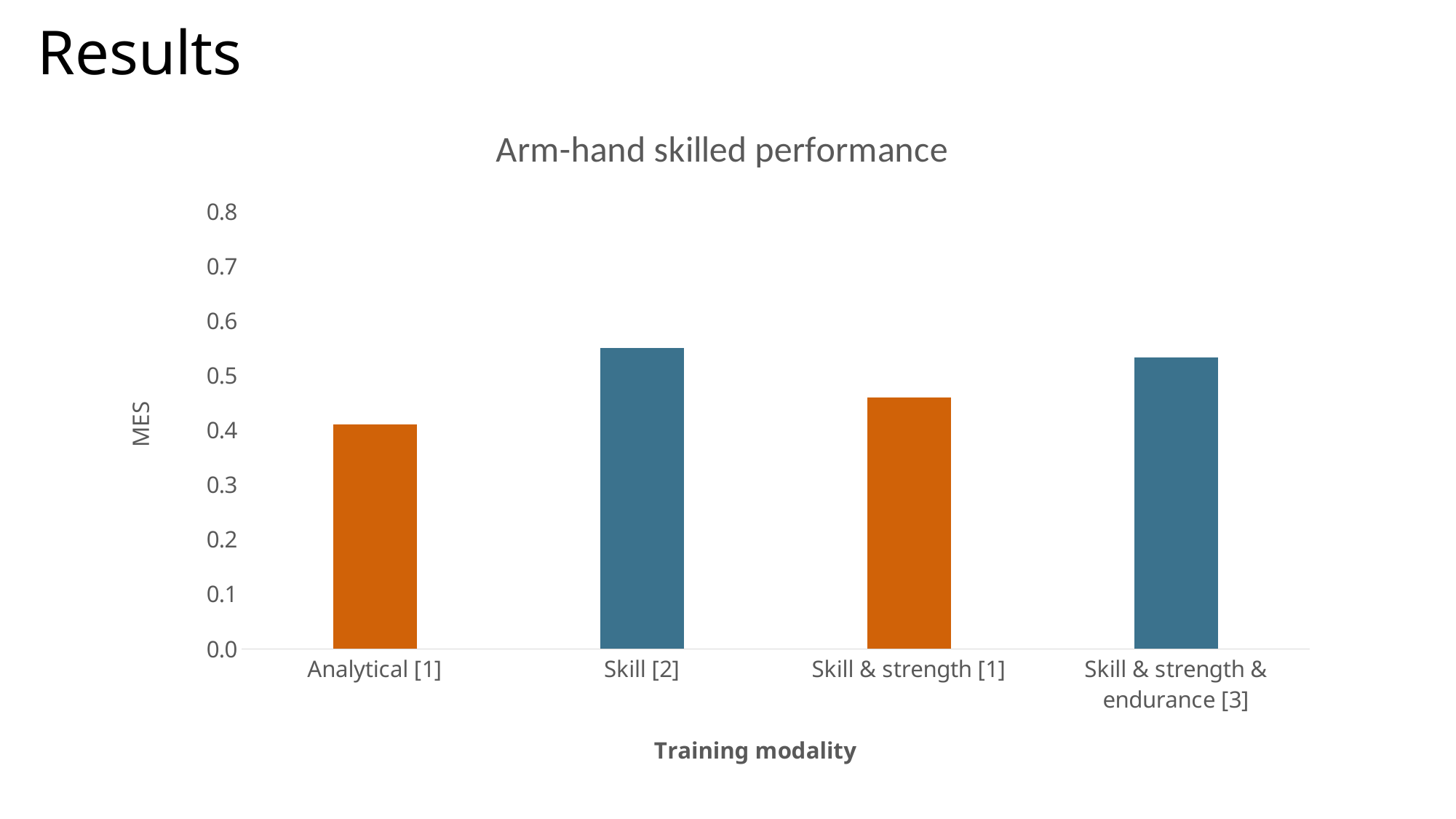
What is the title of the chart? Arm-hand skilled performance Is the MES value for Skill & strength & endurance [3] greater or less than 0.5? greater Is the MES value for Skill & strength [1] greater or less than 0.5? less Which training modality has the lowest MES value? Analytical [1] What is the label of the x axis of the chart? Training modality Is the MES value for Skill [2] greater or less than 0.5? greater What type of chart is shown on the slide? Bar chart Which has a higher MES value, Skill & strength [1] or Analytical [1]? Skill & strength [1] How many training modalities are plotted in the chart? 4 Which has a higher MES value, Skill [2] or Analytical [1]? Skill [2] Which has a higher MES value, Skill & strength & endurance [3] or Skill & strength [1]? Skill & strength & endurance [3]